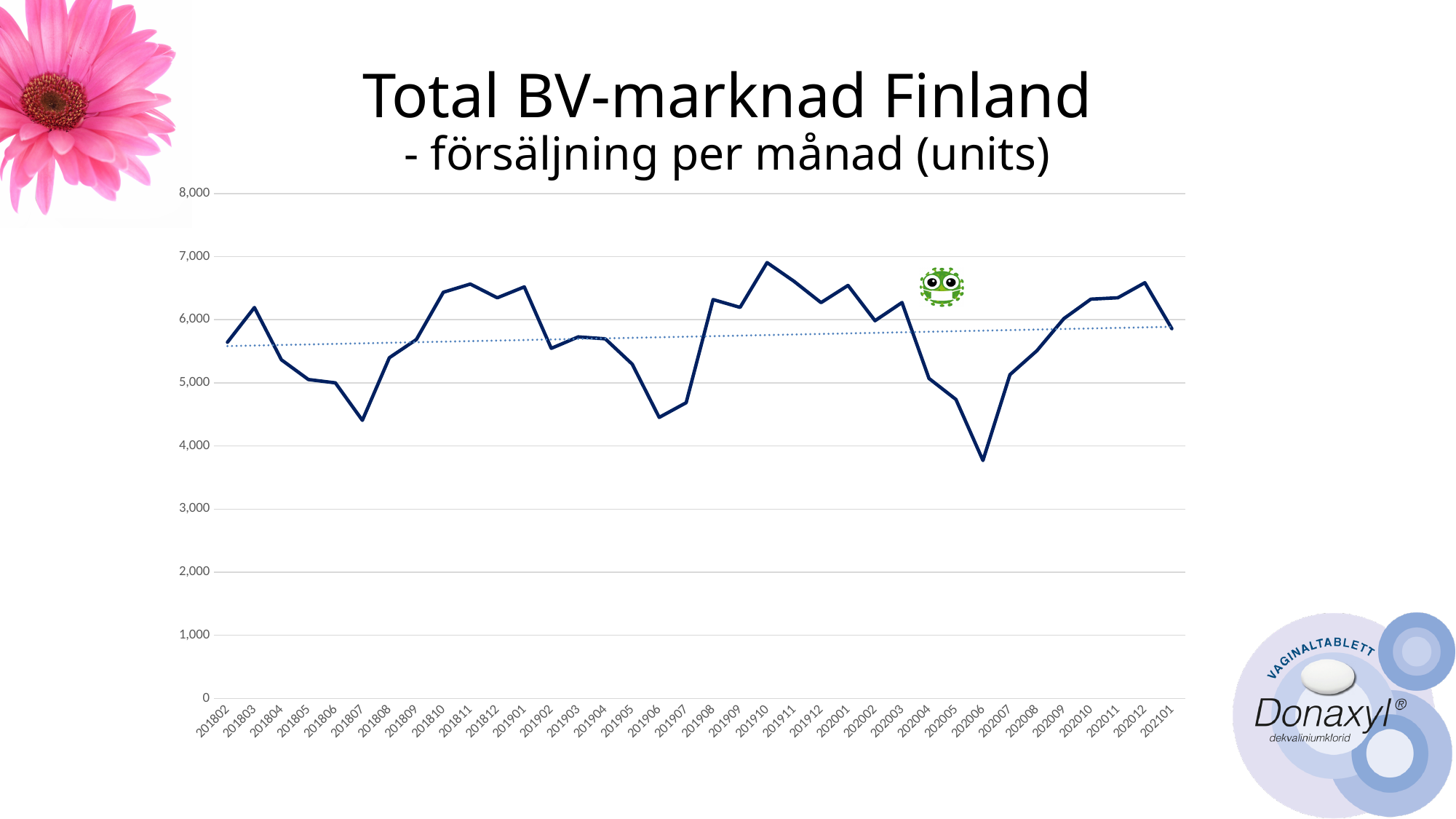
Is the value for 201807 greater or less than 5,000? less Which month has the lowest value on the chart? 202006 Which has the larger value, 201807 or 201811? 201811 Is the value for 202006 greater or less than 4,000? less Do the values rise or fall from 202006 to 202012? rise Is the value for 201910 greater or less than 6,000? greater Which month has the highest value on the chart? 201910 What is the title of the chart? Total BV-marknad Finland - försäljning per månad (units) What kind of chart is shown on the slide? line chart How many months are plotted along the x axis? 36